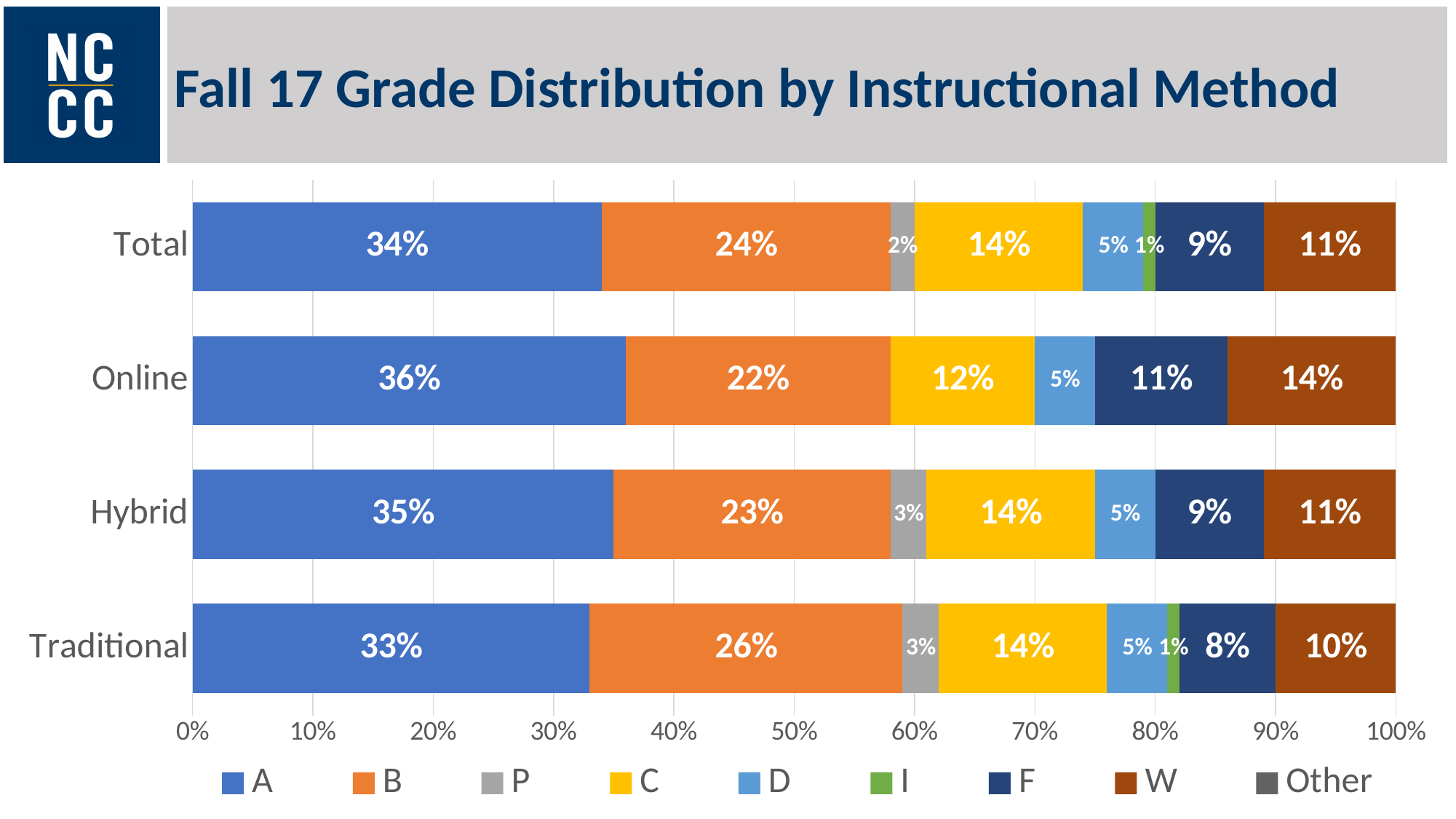
Which instructional method has the highest value for A? Online What is the value for W in the Traditional bar? 10% How many series does the legend list? 9 What is the difference between the B values for Traditional and Online? 4% What is the value for A in the Online bar? 36% What is the value for B in the Total bar? 24% What kind of chart is shown on the slide? Stacked bar chart How many instructional method categories are shown on the y axis? 4 What is the title of the chart? Fall 17 Grade Distribution by Instructional Method What is the value for F in the Hybrid bar? 9% Which instructional method has the lowest value for B? Online Which is larger, the W value for Online or the W value for Hybrid? Online